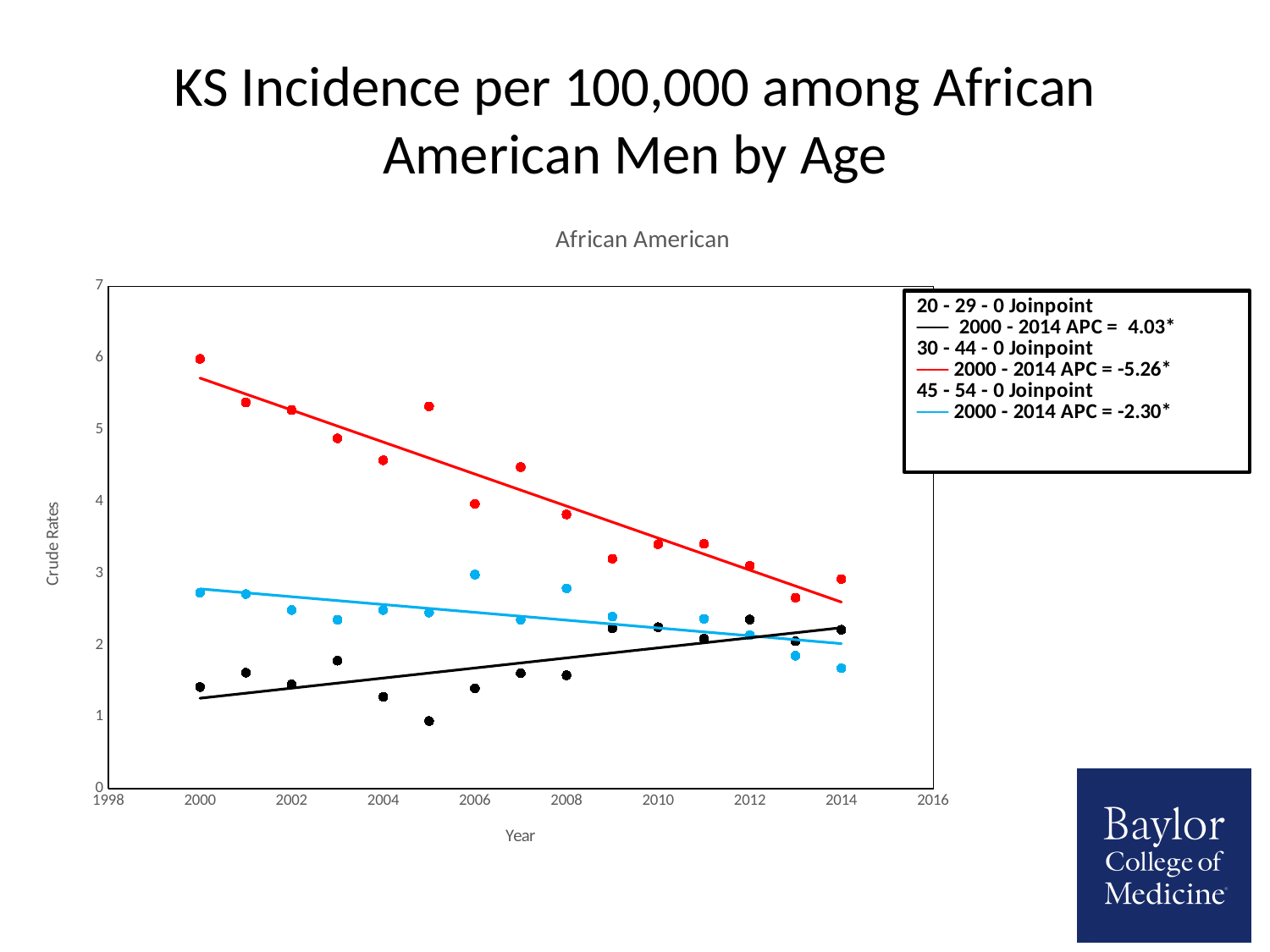
What is the 2000 - 2014 APC for the 30 - 44 age group according to the legend? -5.26* Which age group has the highest crude rate in 2000? 30 - 44 Does the trend line for the 45 - 54 age group rise or fall from 2000 to 2014? Falls In 2000, which is larger: the crude rate for the 45 - 54 age group or the 20 - 29 age group? 45 - 54 Is the crude rate for the 30 - 44 age group in 2000 greater or less than 5? greater Does the trend line for the 30 - 44 age group rise or fall from 2000 to 2014? Falls What is the label on the y axis of the chart? Crude Rates What kind of chart is shown on the slide? Scatter chart with trend lines Does the trend line for the 20 - 29 age group rise or fall from 2000 to 2014? Rises How many series does the legend list? 3 What is the title of the chart? African American